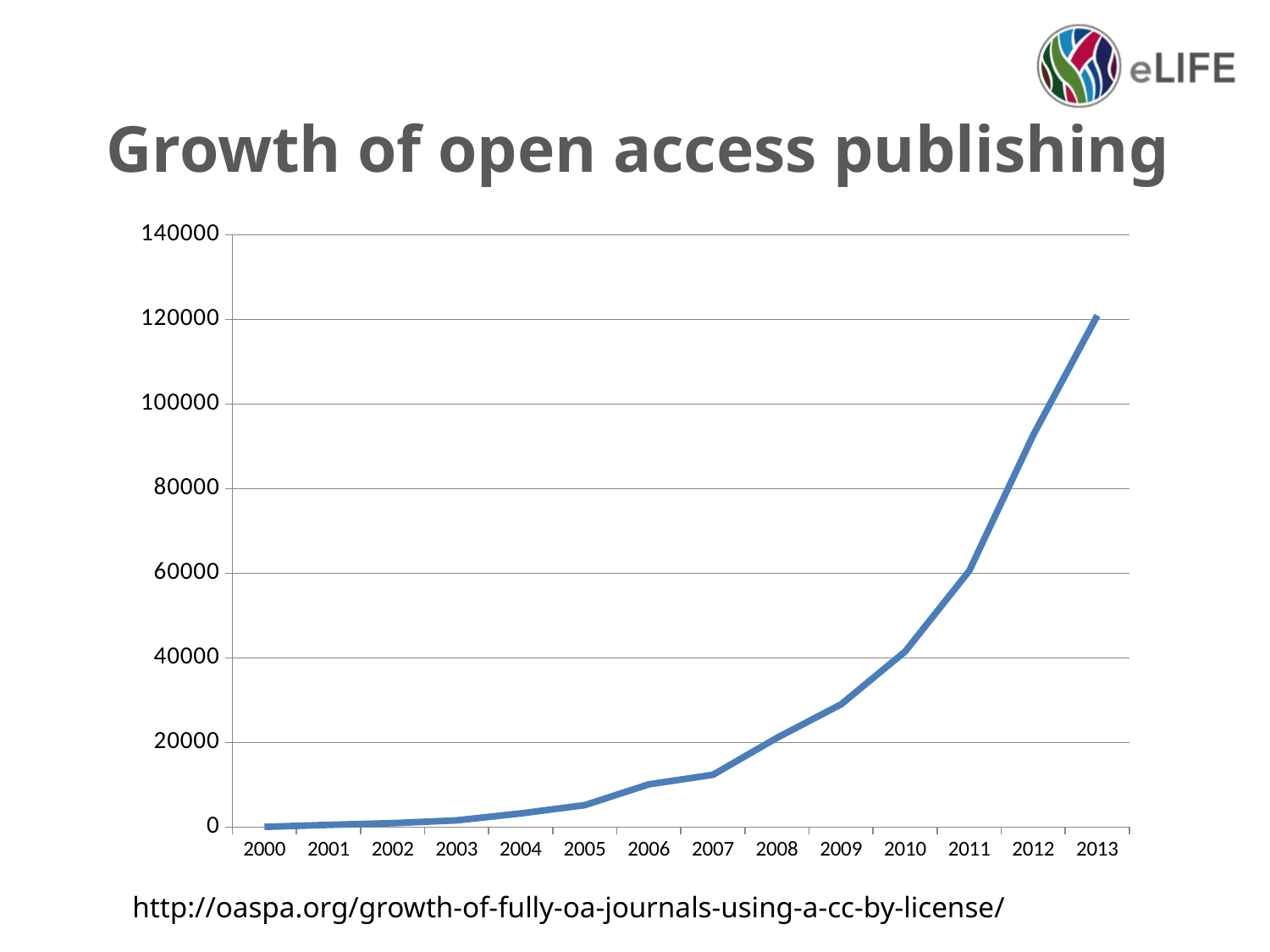
Which year has the lowest value in the chart? 2000 Do the values rise or fall from 2000 to 2013? rise What kind of chart is shown on the slide? line chart What source URL is shown below the chart? http://oaspa.org/growth-of-fully-oa-journals-using-a-cc-by-license/ Which year has the larger value, 2010 or 2013? 2013 Which year has the highest value in the chart? 2013 Is the value for 2012 greater or less than 80000? greater Is the value for 2013 greater or less than 100000? greater What is the title of the chart on the slide? Growth of open access publishing Is the value for 2007 greater or less than 20000? less How many years are plotted along the x axis of the chart? 14